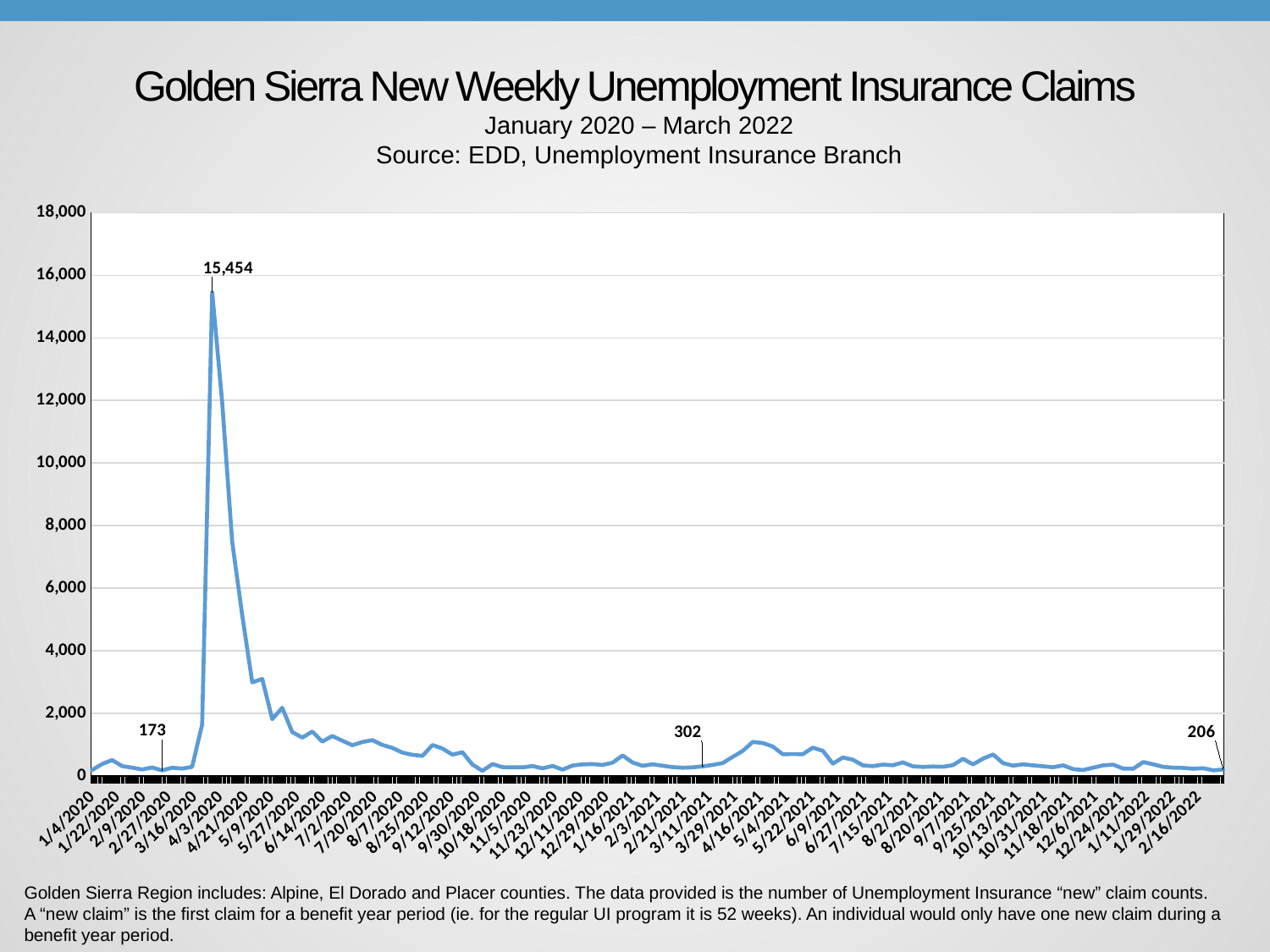
After the peak in spring 2020, do the values generally rise or fall over the following months? fall What is the highest value shown on the vertical axis? 18,000 Is the value for 1/4/2020 greater or less than 2,000? less Is the value for 2/16/2022 greater or less than 2,000? less What is the highest value labeled on the chart? 15,454 Which labeled value is larger, 302 or 206? 302 What is the value labeled at the far right end of the line, in early 2022? 206 What is the difference between the peak value of 15,454 and the final labeled value of 206? 15,248 What is the difference between the labeled values 302 and 173? 129 What is the value labeled on the line in early 2020, before the spike? 173 What type of chart is shown on the slide? line chart What is the value labeled on the line in March 2021? 302